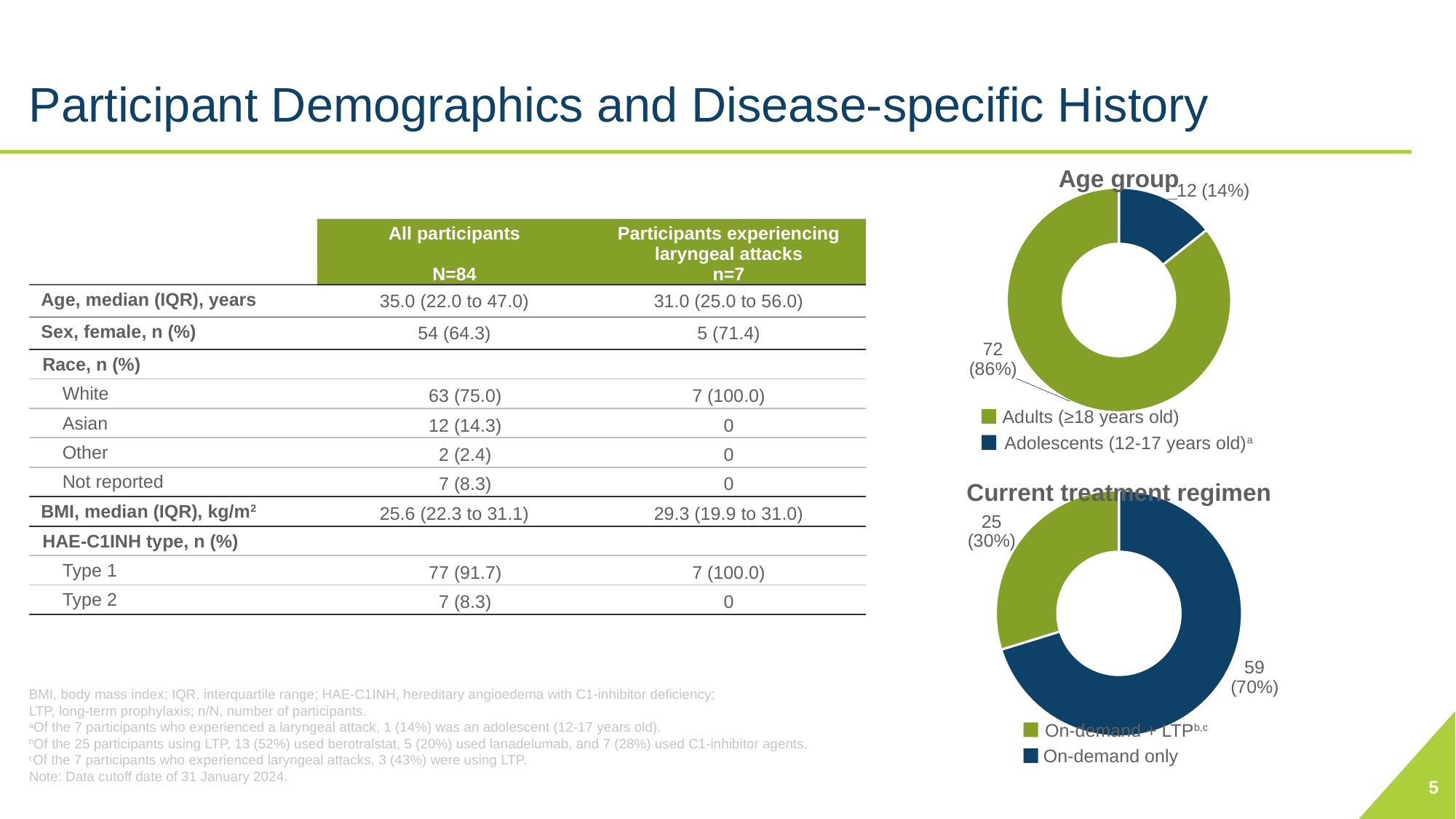
In the Current treatment regimen chart, what share of participants use on-demand + LTP? 30% In the Age group chart, how many participants are adults (≥18 years old)? 72 In the Current treatment regimen chart, what colour represents on-demand only? Dark blue What type of chart is the Age group chart? Donut (pie) chart In the Current treatment regimen chart, is the number of participants on-demand only larger or smaller than the number using on-demand + LTP? larger In the Age group chart, what percentage of participants are adolescents (12-17 years old)? 14% In the Current treatment regimen chart, how many participants are on-demand only? 59 In the Age group chart, which category has the larger share? Adults (≥18 years old) In the Age group chart, how many categories are shown? 2 In the Current treatment regimen chart, which category has the smaller share? On-demand + LTP In the Current treatment regimen chart, what is the difference between the on-demand only and on-demand + LTP counts? 34 In the Age group chart, what is the difference in number of participants between adults and adolescents? 60